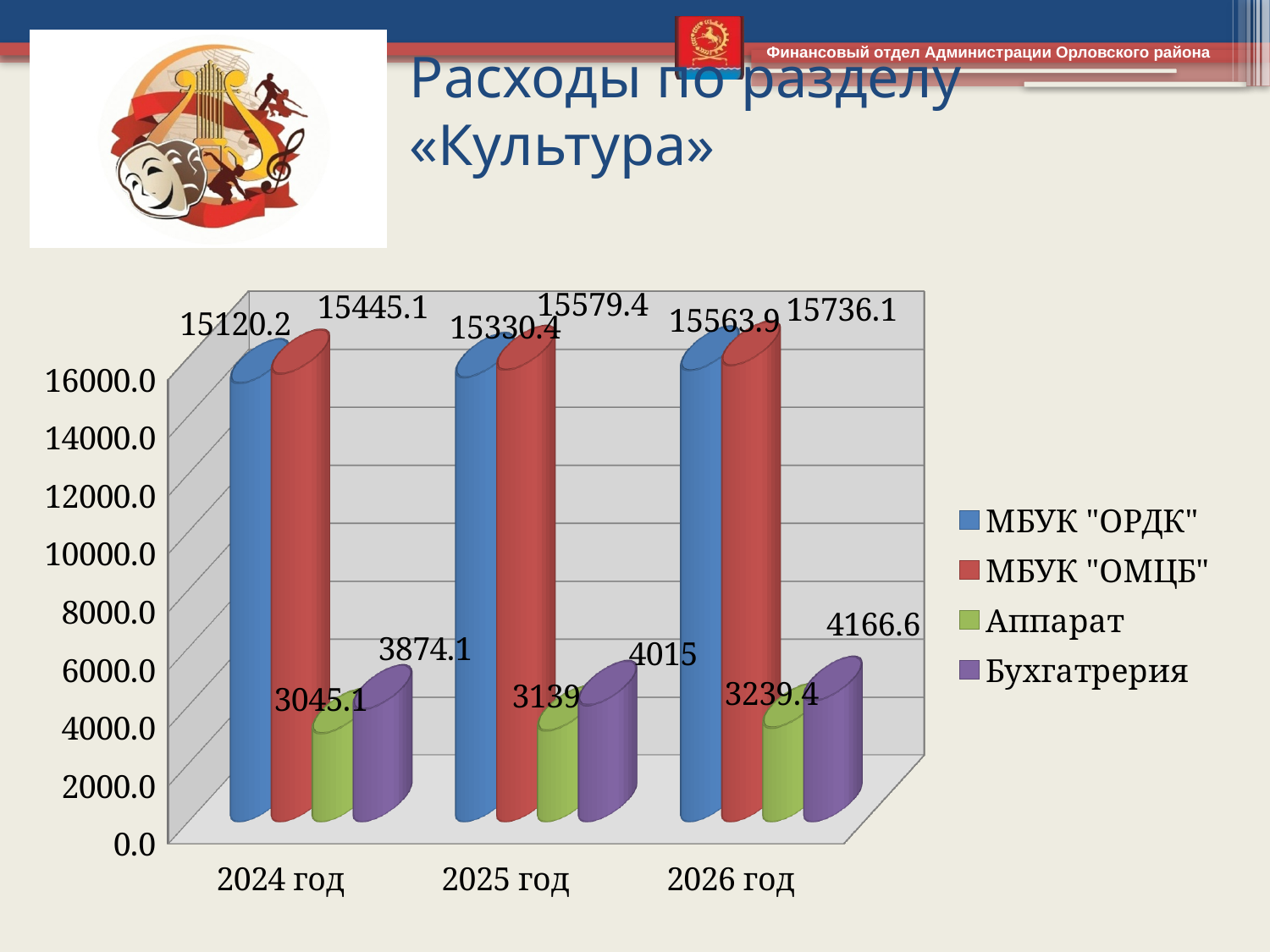
What is the value for Бухгатрерия in 2024 год? 3874.1 How many year categories are shown on the x axis? 3 What is the value for Аппарат in 2025 год? 3139 Which is larger: Бухгатрерия in 2026 год or Аппарат in 2026 год? Бухгатрерия in 2026 год What is the difference between the МБУК "ОМЦБ" and МБУК "ОРДК" values in 2025 год? 249 What is the value for МБУК "ОРДК" in 2024 год? 15120.2 How many series does the legend list? 4 What kind of chart is shown on the slide? Bar chart Which series has the lowest value in 2025 год? Аппарат What is the value for МБУК "ОМЦБ" in 2026 год? 15736.1 Do the values for Аппарат rise or fall from 2024 год to 2026 год? Rise Which series has the highest value in 2026 год? МБУК "ОМЦБ"